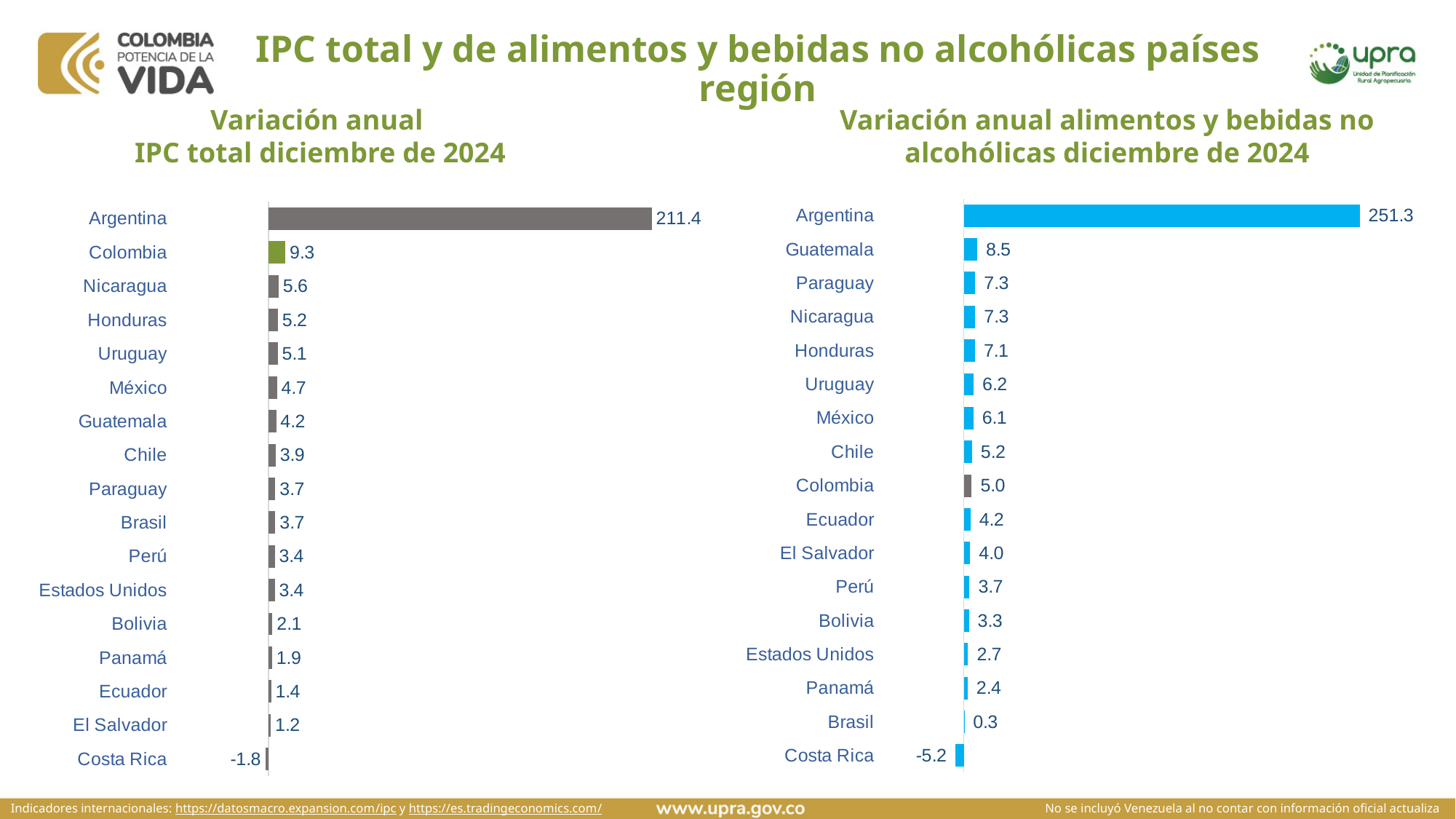
In the chart 'Variación anual IPC total diciembre de 2024', which country has the highest value? Argentina In the chart 'Variación anual IPC total diciembre de 2024', which country has the lowest value? Costa Rica In the chart 'Variación anual alimentos y bebidas no alcohólicas diciembre de 2024', which is larger, the value for Chile or the value for Colombia? Chile In the chart 'Variación anual IPC total diciembre de 2024', what is the value for Colombia? 9.3 In the chart 'Variación anual alimentos y bebidas no alcohólicas diciembre de 2024', which country has the lowest value? Costa Rica What kind of chart is 'Variación anual IPC total diciembre de 2024'? Bar chart In the chart 'Variación anual alimentos y bebidas no alcohólicas diciembre de 2024', what is the difference between the values for Argentina and Guatemala? 242.8 In the chart 'Variación anual alimentos y bebidas no alcohólicas diciembre de 2024', what is the value for Guatemala? 8.5 In the chart 'Variación anual IPC total diciembre de 2024', which country's bar is coloured green? Colombia In the chart 'Variación anual IPC total diciembre de 2024', how many countries are shown? 17 In the chart 'Variación anual IPC total diciembre de 2024', what is the difference between the values for Nicaragua and Honduras? 0.4 In the chart 'Variación anual alimentos y bebidas no alcohólicas diciembre de 2024', what is the value for Costa Rica? -5.2